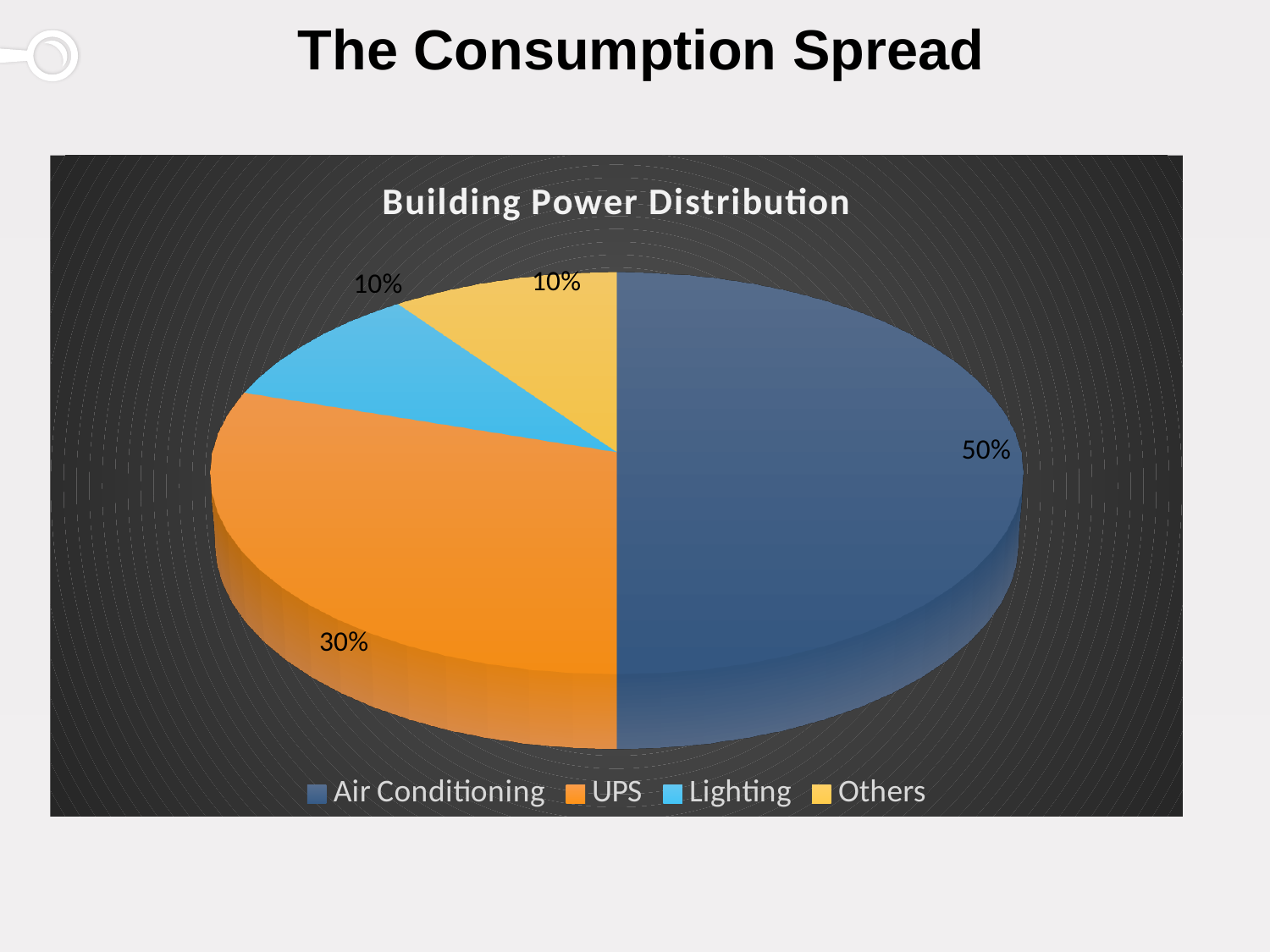
What is the difference in percentage points between Air Conditioning and UPS? 20% What is the title of the chart? Building Power Distribution Which is larger, the share for UPS or the share for Lighting? UPS What kind of chart is shown on the slide? pie chart How many categories does the legend list? 4 What share of building power does Lighting account for? 10% What share of building power does Others account for? 10% What share of building power does Air Conditioning account for? 50% What is the combined share of Lighting and Others? 20% What share of building power does UPS account for? 30% Which colour represents UPS in the legend? orange Which category has the largest share of the pie? Air Conditioning